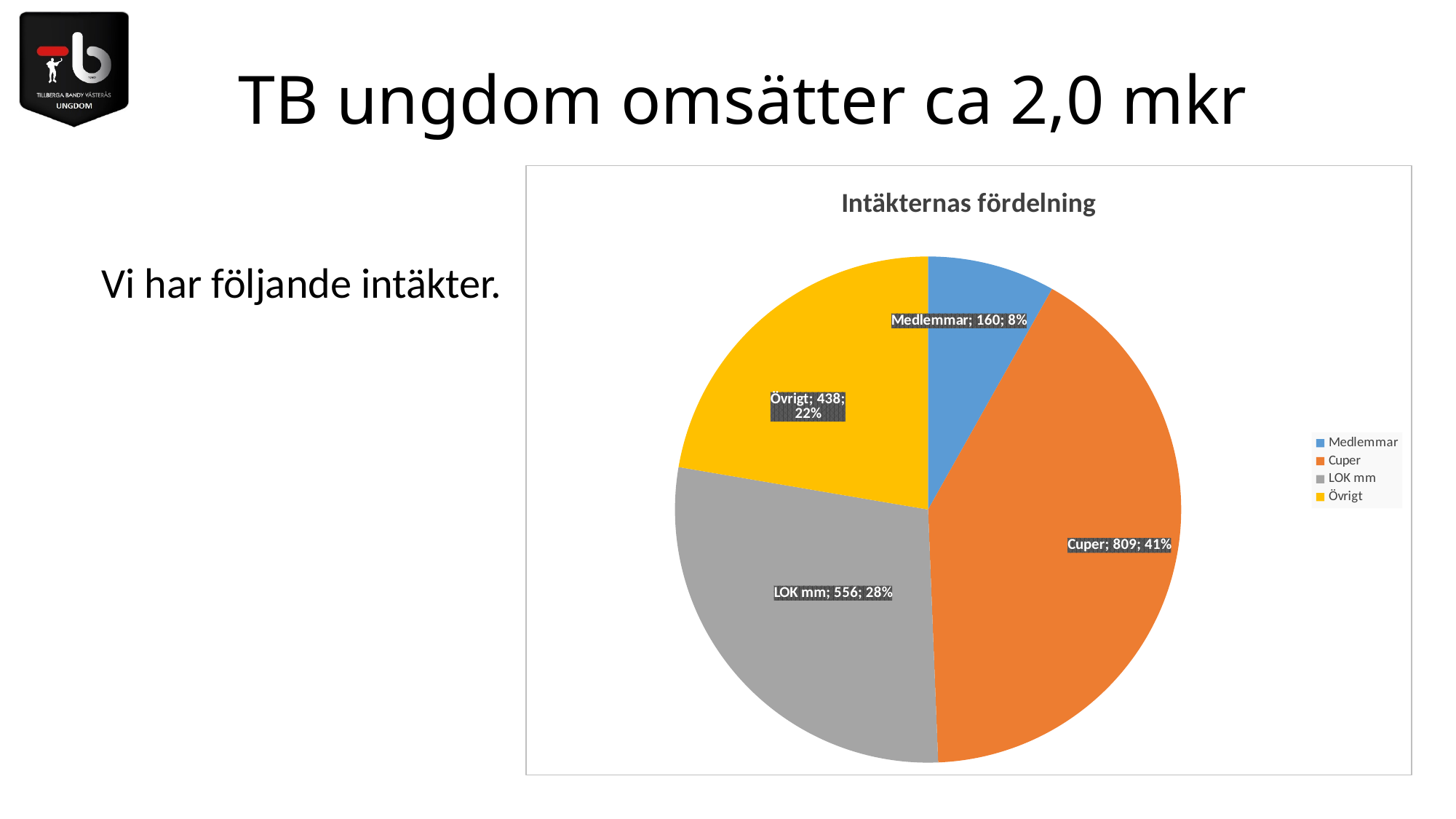
What is the title of the chart? Intäkternas fördelning How many categories does the legend list? 4 Which category has the largest slice? Cuper What type of chart is shown on the slide? pie chart What is the value for Medlemmar? 160 What is the value for Cuper? 809 What is the value for Övrigt? 438 Which category has the smallest slice? Medlemmar Which is larger, the value for LOK mm or the value for Övrigt? LOK mm What is the difference between the values for Cuper and Övrigt? 371 What share of the pie does LOK mm represent? 28% What is the value for LOK mm? 556